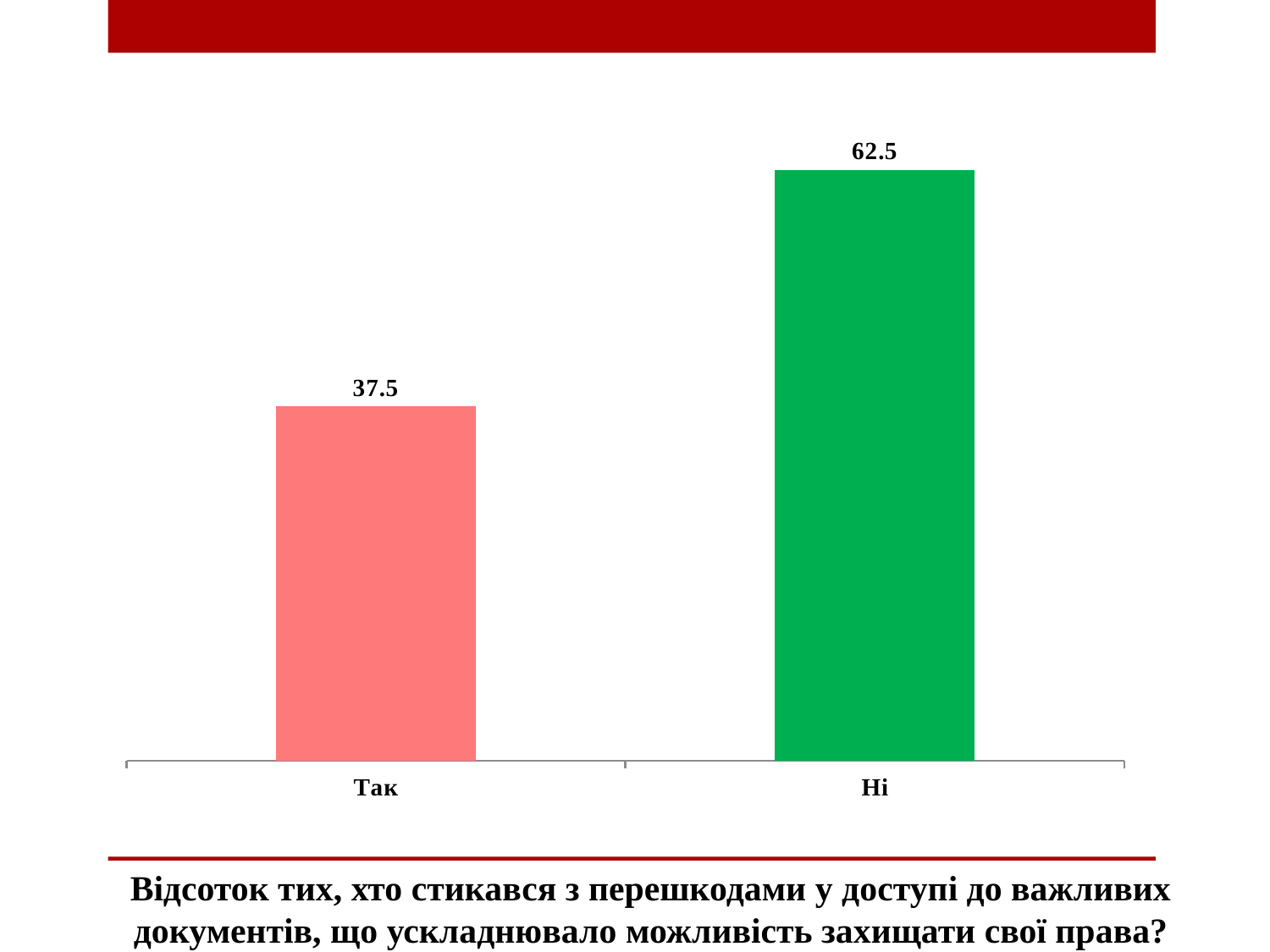
What is the value for "Так"? 37.5 How many categories are shown in the chart? 2 What colour is the bar for "Так"? Pink (light red) Which is larger, the value for "Так" or the value for "Ні"? Ні What is the total of the two values shown in the chart? 100 What is the difference between the values for "Ні" and "Так"? 25 What kind of chart is shown on the slide? Bar chart What is the value for "Ні"? 62.5 Which category has the lowest value? Так Which category has the highest value? Ні What colour is the bar for "Ні"? Green